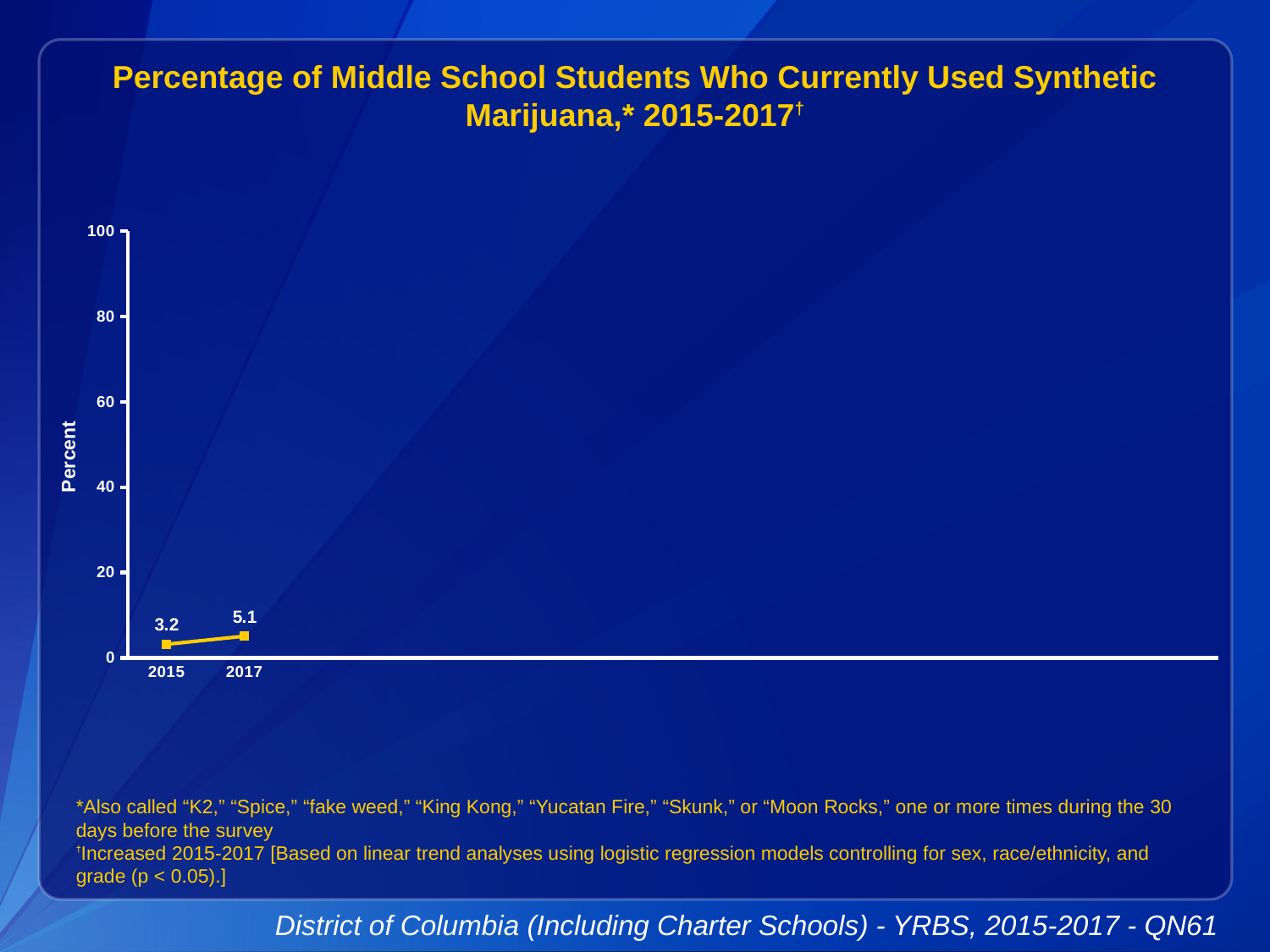
Is the value for 2017 greater or less than 20? less Do the values rise or fall from 2015 to 2017? rise What is the maximum value shown on the y axis? 100 How many data points are plotted on the chart? 2 What is the value for 2017? 5.1 Which is larger, the value for 2015 or the value for 2017? 2017 What is the value for 2015? 3.2 What kind of chart is shown on the slide? line chart Which year has the highest value? 2017 Which year has the lowest value? 2015 What is the label on the y axis? Percent What is the difference between the values for 2017 and 2015? 1.9